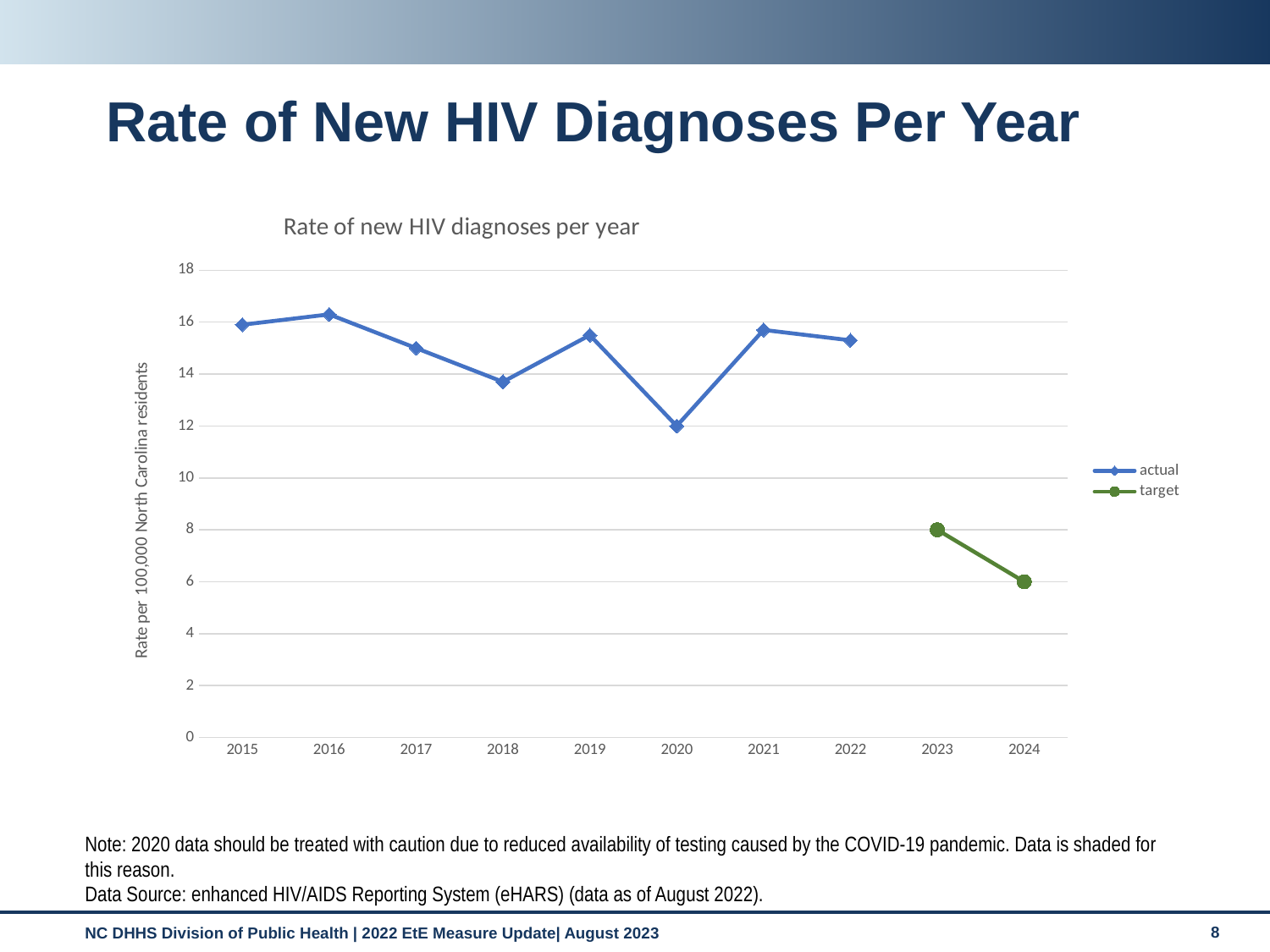
In which year is the actual rate highest? 2016 What kind of chart is shown on the slide? line chart How many years are shown on the x axis? 10 What are the two series named in the legend? actual and target How many series does the legend list? 2 Which is larger, the actual rate in 2019 or the actual rate in 2020? 2019 In which year is the actual rate lowest? 2020 Is the actual rate for 2018 greater or less than 14? less What is the target rate for 2023? 8 Is the actual rate for 2021 greater or less than 14? greater What is the target rate for 2024? 6 What is the difference between the 2023 target and the 2024 target? 2